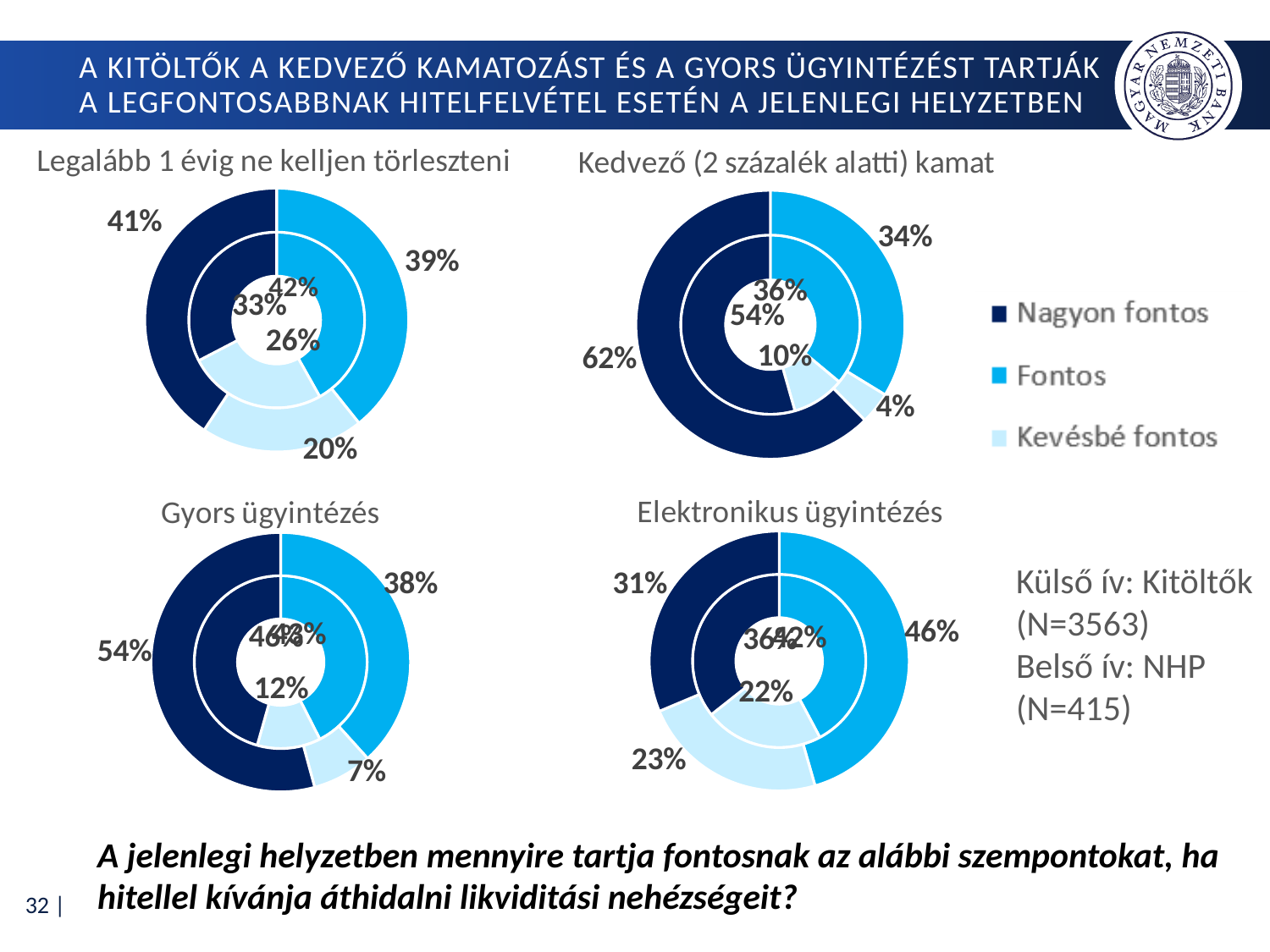
In the 'Gyors ügyintézés' chart, which category has the smallest share in the outer ring (Kitöltők)? Kevésbé fontos In the 'Kedvező (2 százalék alatti) kamat' chart, what share of the outer ring (Kitöltők) is 'Kevésbé fontos'? 4% In the 'Kedvező (2 százalék alatti) kamat' chart, what share of the inner ring (NHP) is 'Nagyon fontos'? 54% What kind of chart is used for 'Gyors ügyintézés'? Doughnut chart In the 'Elektronikus ügyintézés' chart, what share of the outer ring (Kitöltők) is 'Fontos'? 46% In the 'Legalább 1 évig ne kelljen törleszteni' chart, what share of the outer ring (Kitöltők) is 'Fontos'? 39% In the 'Elektronikus ügyintézés' chart, which category has the largest share in the outer ring (Kitöltők)? Fontos In the 'Legalább 1 évig ne kelljen törleszteni' chart, which outer-ring share is larger: 'Nagyon fontos' or 'Kevésbé fontos'? Nagyon fontos How many categories does the legend list for the charts? 3 In the 'Gyors ügyintézés' chart, what share of the outer ring (Kitöltők) is 'Kevésbé fontos'? 7% In the 'Kedvező (2 százalék alatti) kamat' chart, what share of the outer ring (Kitöltők) is 'Nagyon fontos'? 62% In the 'Kedvező (2 százalék alatti) kamat' chart, what is the difference between the outer-ring 'Nagyon fontos' share (62%) and the outer-ring 'Fontos' share (34%)? 28 percentage points